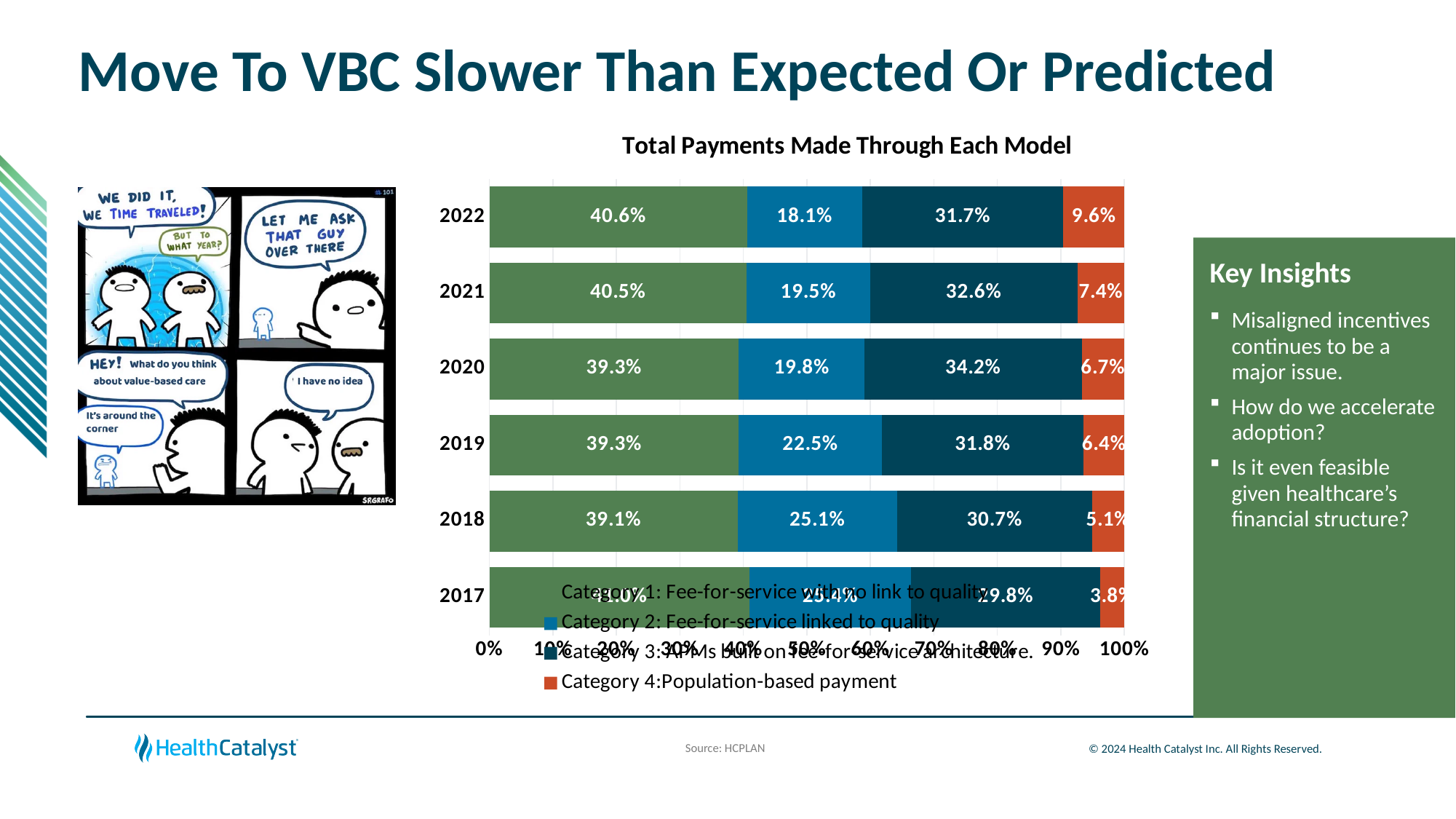
Which is larger: the Category 3 value in 2021 or in 2019? 2021 Which year has the highest value for Category 4 (Population-based payment)? 2022 How many series does the legend of the chart list? 4 Does the Category 4 (Population-based payment) value rise or fall from 2017 to 2022? Rise What is the value for Category 3 (APMs built on fee-for-service architecture) in 2020? 34.2% What is the value for Category 1 (Fee-for-service with no link to quality) in 2022? 40.6% What type of chart is shown under the title "Total Payments Made Through Each Model"? Stacked bar chart What is the value for Category 2 (Fee-for-service linked to quality) in 2019? 22.5% How many years are shown on the chart? 6 What is the value for Category 4 (Population-based payment) in 2018? 5.1% What is the difference between the Category 2 values for 2018 and 2022? 7.0% Which year has the lowest value for Category 4 (Population-based payment)? 2017